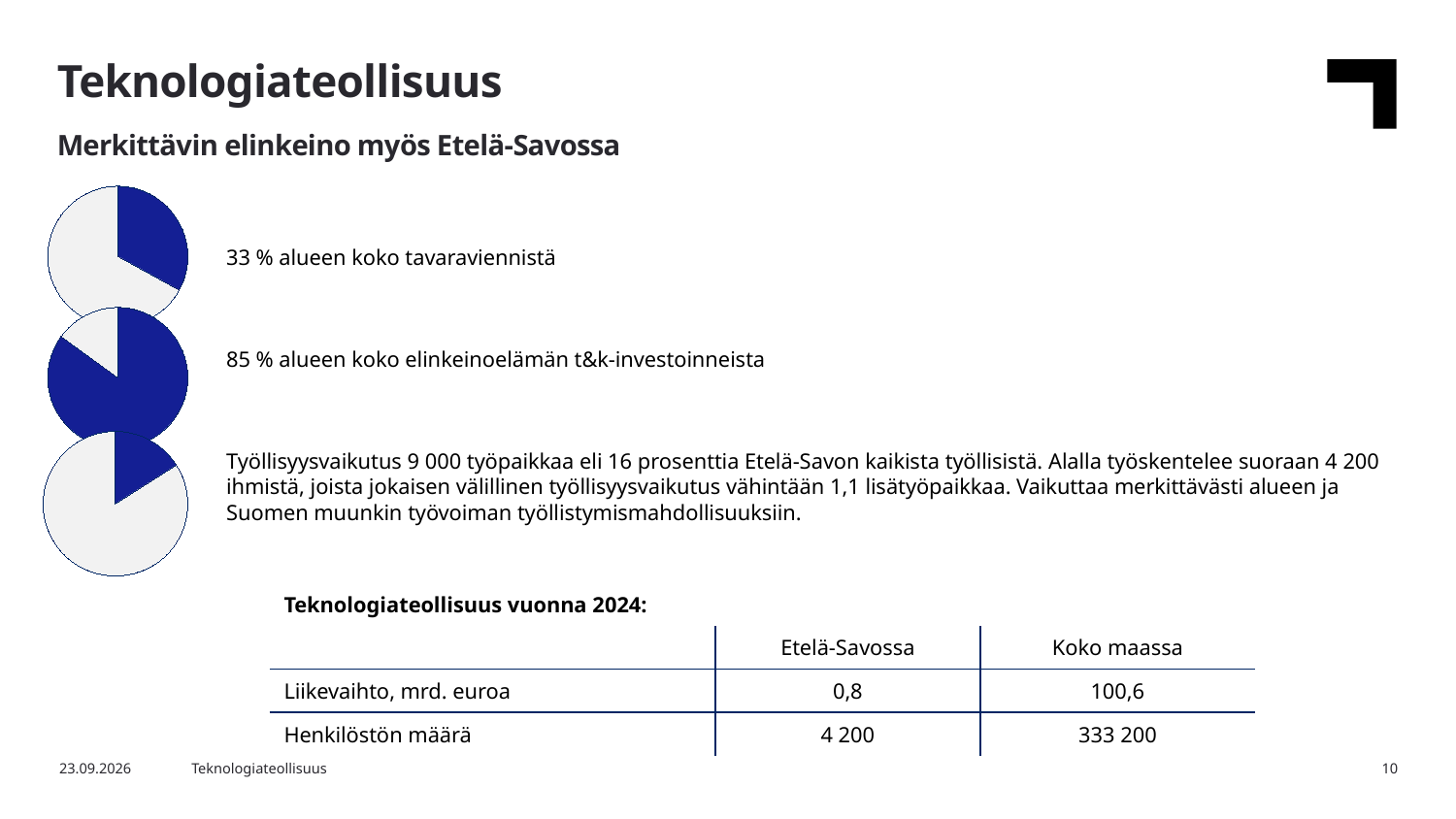
Which pie chart has the largest blue slice: the top, middle or bottom one? middle Which pie chart has the smallest blue slice: the top, middle or bottom one? bottom What kind of chart is shown on the left side of the slide? pie chart What colour is the highlighted slice in each pie chart? blue In the middle pie chart, what share of the region's business R&D investments does the blue slice represent? 85 % How many pie charts are on the slide? 3 In the middle pie chart, is the blue slice greater or less than 50% of the pie? greater In the top pie chart, is the blue slice greater or less than 50% of the pie? less In the top pie chart, what share of the region's total goods exports does the blue slice represent? 33 % Is the blue slice larger in the top pie chart or in the bottom pie chart? top How many slices does each pie chart have? 2 In the bottom pie chart, what share of all employed people in Etelä-Savo does the blue slice represent? 16 prosenttia